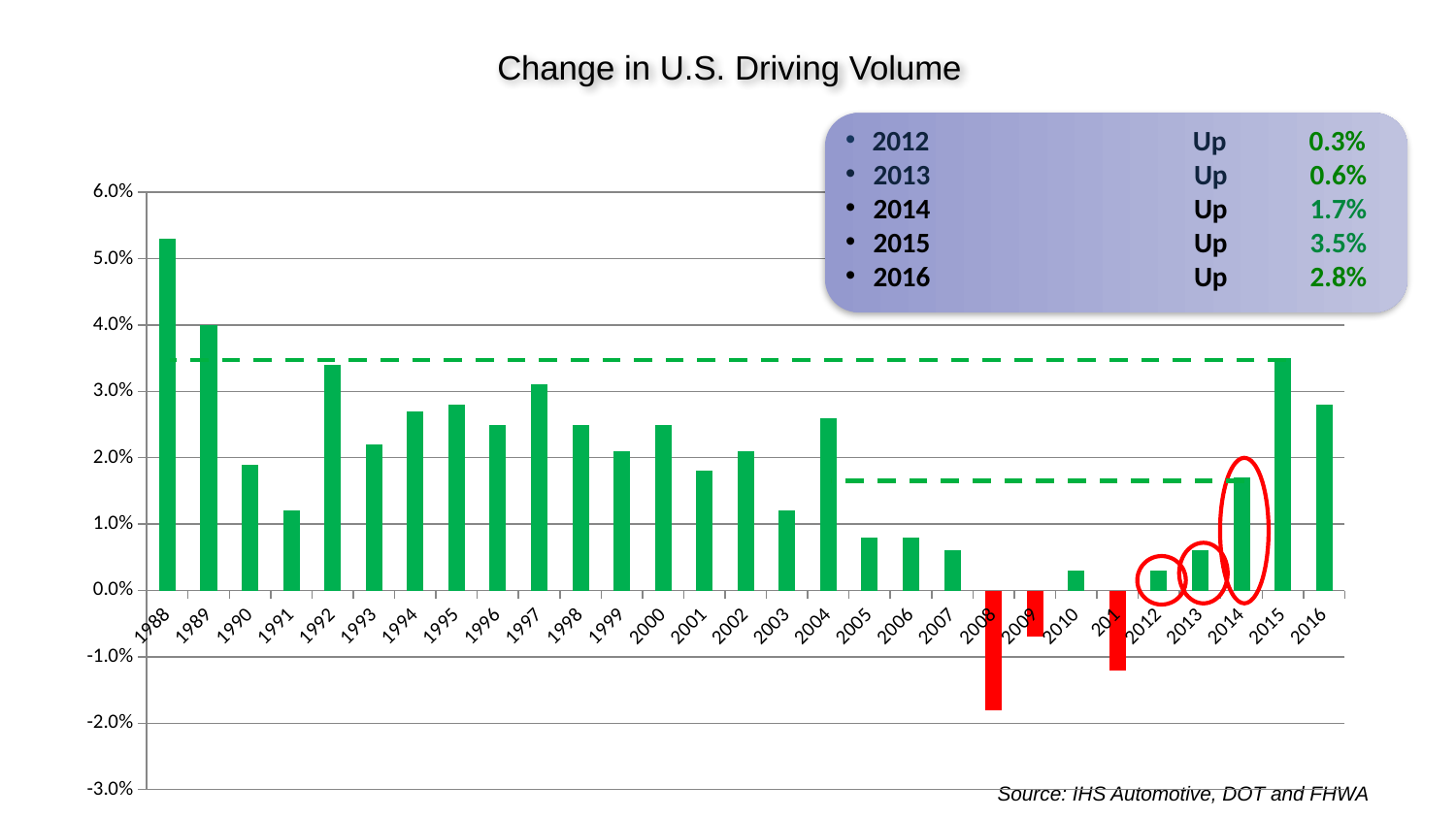
What is the difference between the 2015 and 2013 changes in driving volume shown on the slide? 2.9% Which year has the larger change in driving volume, 2015 or 2016? 2015 Which year has the highest change in U.S. driving volume? 1988 How many years are plotted on the x axis of the chart? 29 According to the slide, what was the change in U.S. driving volume in 2014? Up 1.7% According to the slide, what was the change in U.S. driving volume in 2012? Up 0.3% What type of chart is shown on the slide? bar chart According to the slide, what was the change in U.S. driving volume in 2015? Up 3.5% Is the value for 1989 greater or less than 3.0%? greater Is the value for 2011 greater or less than 0.0%? less What is the title of the chart? Change in U.S. Driving Volume Which year has the lowest change in U.S. driving volume? 2008